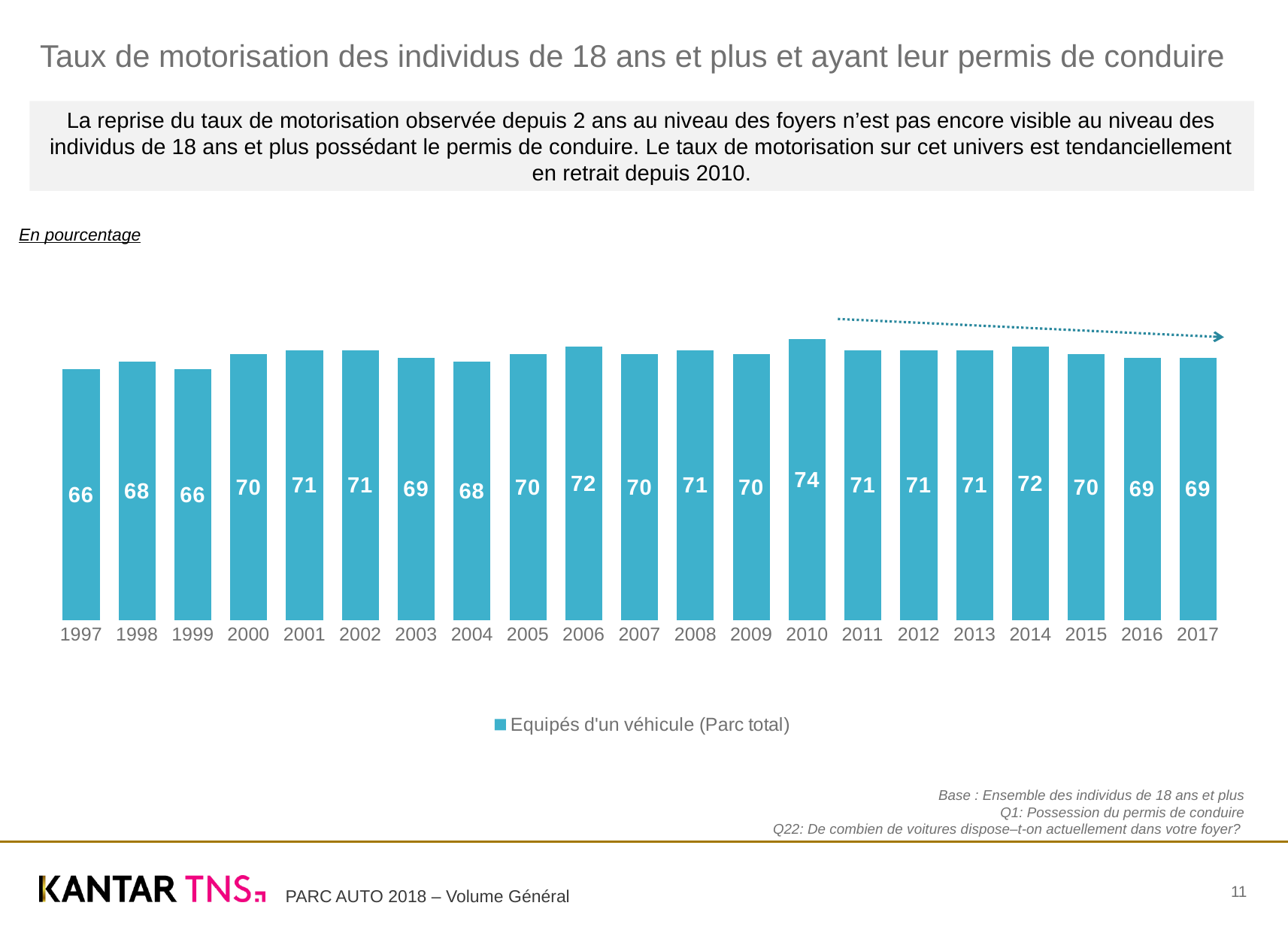
What is the difference between the values for 2014 and 2016? 3 How many years are shown on the x axis? 21 What is the value for 2017? 69 How many series does the legend list? 1 What is the legend entry for the series? Equipés d'un véhicule (Parc total) What is the value for 1997? 66 What is the value for 2010? 74 Do the values rise or fall from 2010 to 2017? fall Which is larger, the value for 2006 or the value for 2004? 2006 What kind of chart is shown? bar chart Which year has the highest value? 2010 What is the difference between the values for 2010 and 2017? 5